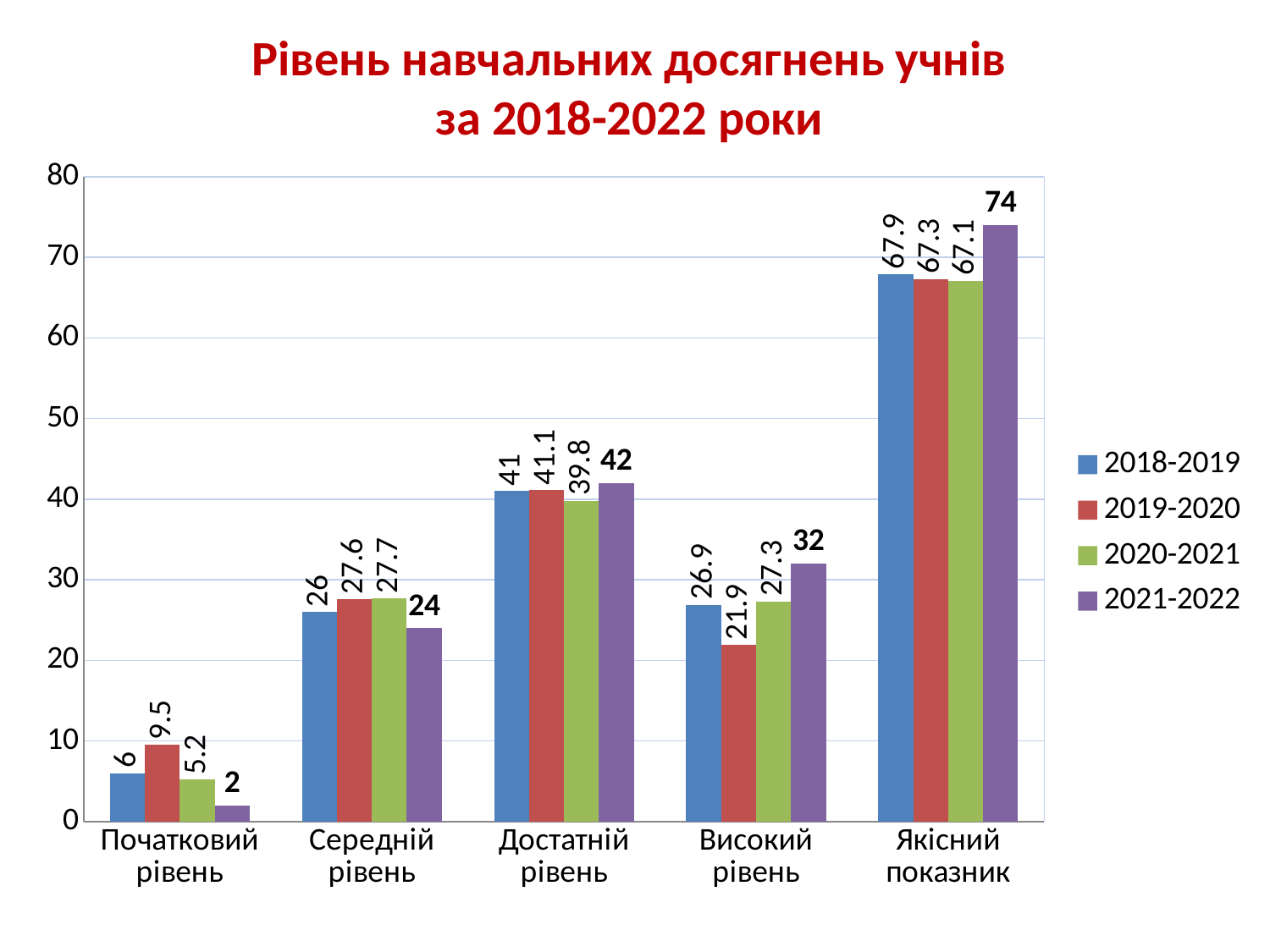
What is the title of the chart? Рівень навчальних досягнень учнів за 2018-2022 роки What kind of chart is shown on the slide? bar chart How many categories are shown on the x axis? 5 What is the value for 2021-2022 in the Якісний показник category? 74 What is the difference between the 2021-2022 and 2018-2019 values in the Якісний показник category? 6.1 Which series has the highest value in the Високий рівень category? 2021-2022 What is the value for 2019-2020 in the Початковий рівень category? 9.5 What is the value for 2020-2021 in the Достатній рівень category? 39.8 Which series has the lowest value in the Початковий рівень category? 2021-2022 Which is larger in the Середній рівень category: the 2018-2019 value or the 2020-2021 value? 2020-2021 Is the value for 2019-2020 in the Високий рівень category greater or less than 30? less How many series does the legend list? 4